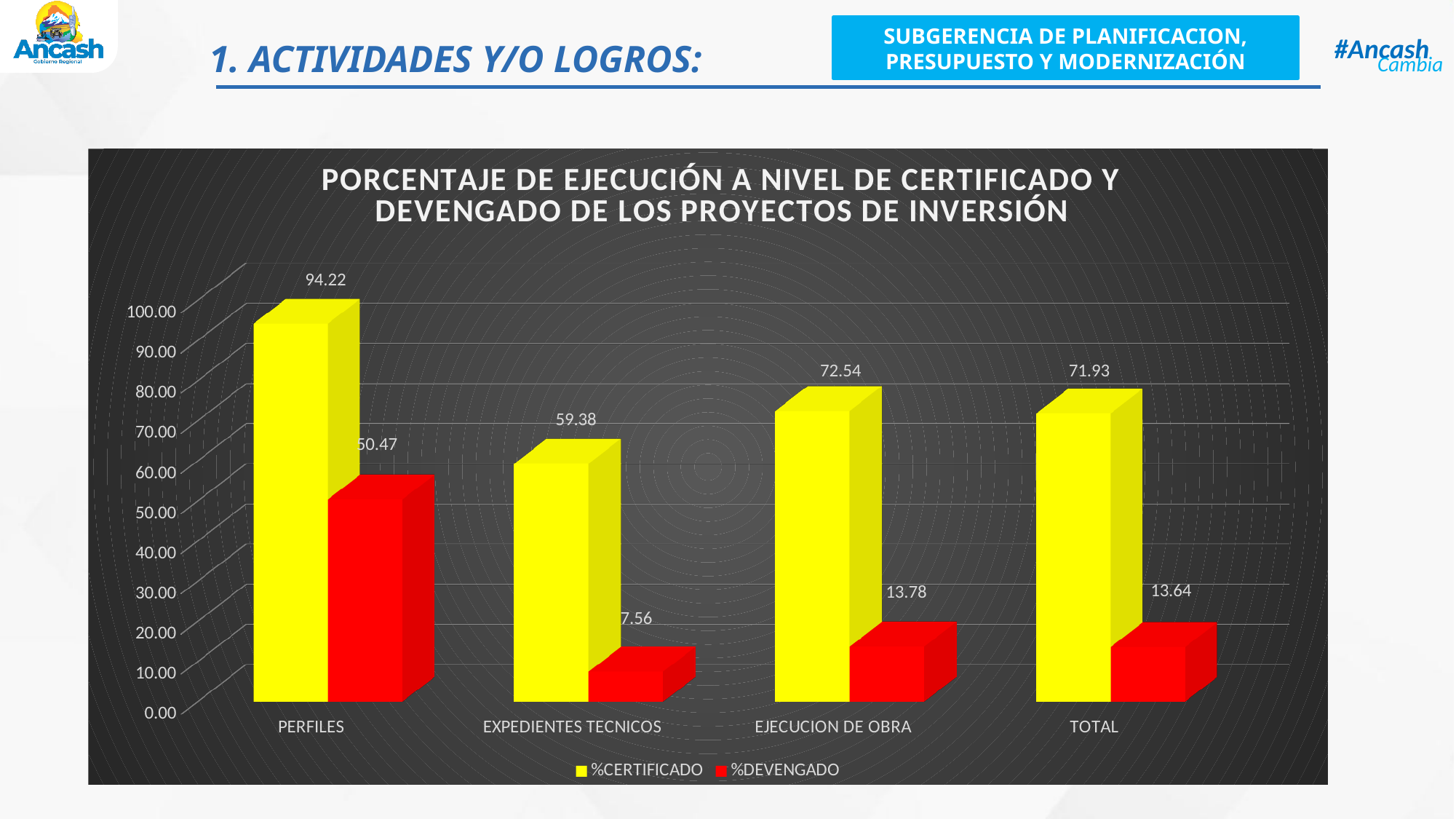
What is the %CERTIFICADO value for TOTAL? 71.93 What kind of chart is shown on the slide? Bar chart What is the %CERTIFICADO value for EXPEDIENTES TECNICOS? 59.38 What is the %DEVENGADO value for EJECUCION DE OBRA? 13.78 Which category has the highest %CERTIFICADO value? PERFILES Which has the larger %CERTIFICADO value, EJECUCION DE OBRA or TOTAL? EJECUCION DE OBRA Which category has the lowest %DEVENGADO value? EXPEDIENTES TECNICOS What is the %CERTIFICADO value for PERFILES? 94.22 What is the difference between the %CERTIFICADO and %DEVENGADO values for PERFILES? 43.75 How many categories are shown on the x axis of the chart? 4 What is the %DEVENGADO value for TOTAL? 13.64 How many series does the chart's legend list? 2